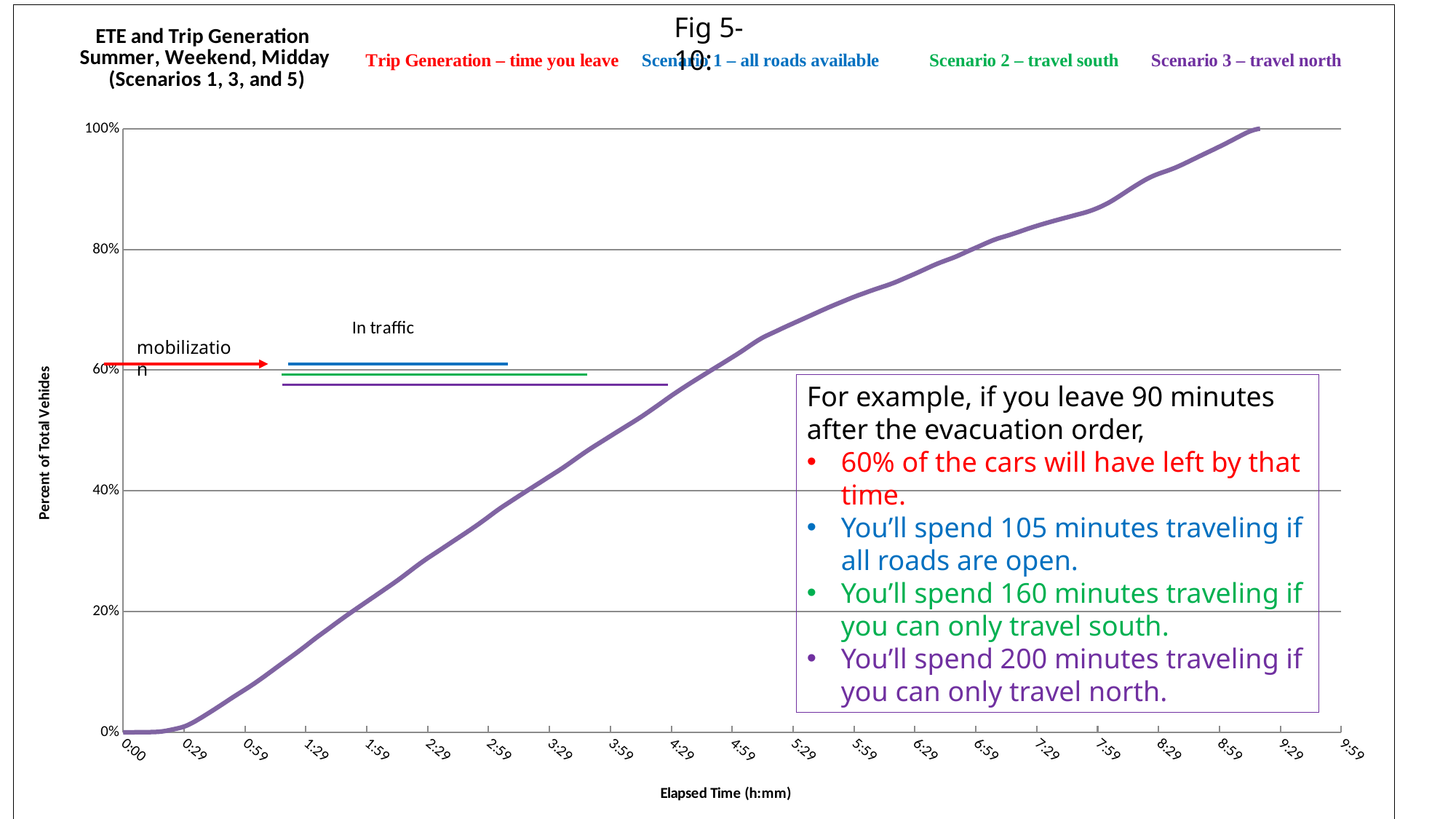
Is the value at elapsed time 2:59 greater or less than 40%? less Does the plotted line rise or fall as elapsed time increases? rise Is the value at elapsed time 4:59 greater or less than 60%? greater Is the value at elapsed time 5:59 greater or less than 80%? less What is the title of the chart? ETE and Trip Generation Summer, Weekend, Midday (Scenarios 1, 3, and 5) What is the label of the x axis? Elapsed Time (h:mm) What is the value of the line at elapsed time 0:00? 0% What kind of chart is shown on the slide? line chart How many tick labels are shown on the x axis? 21 What is the highest value the line reaches? 100%